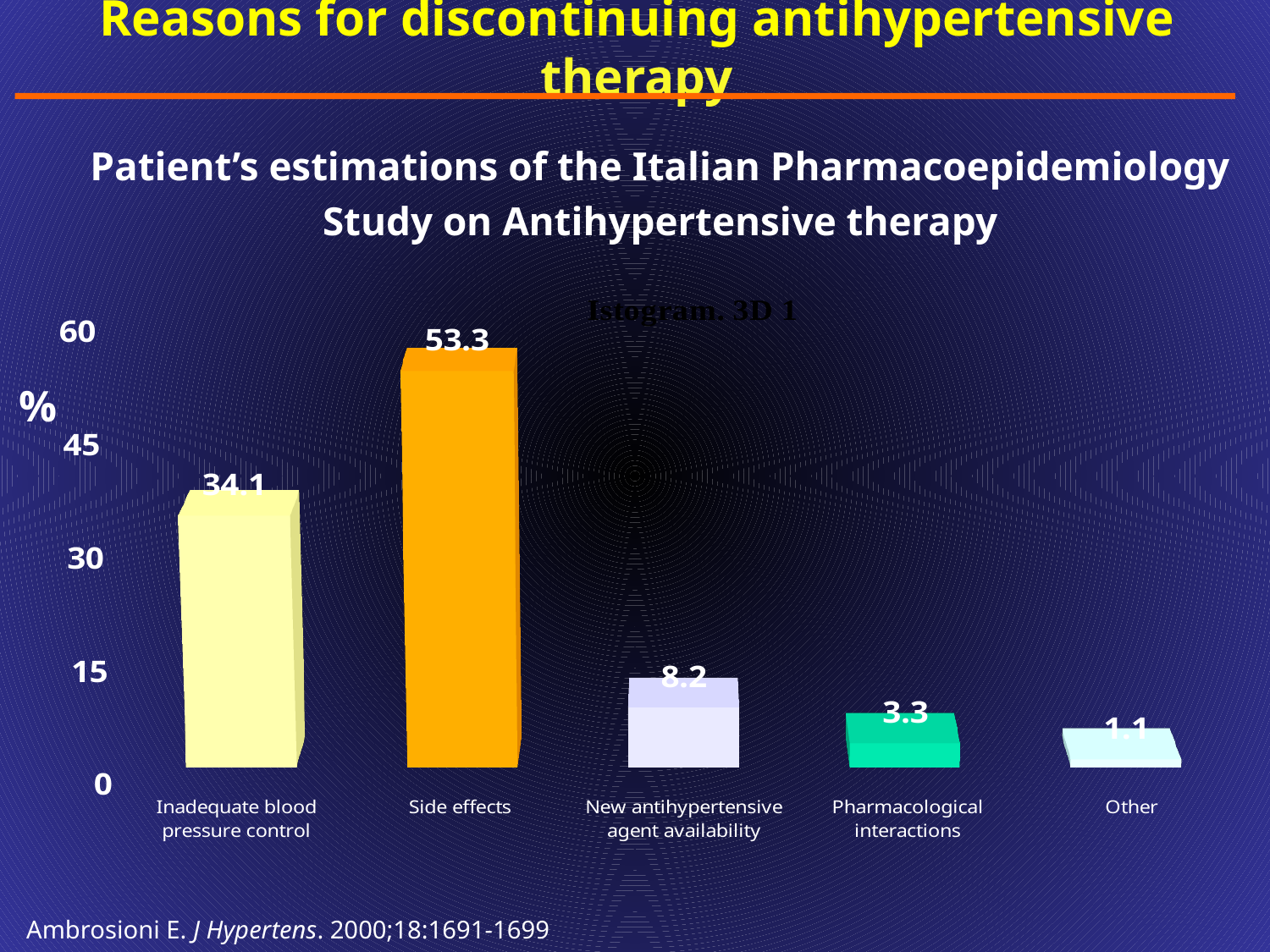
What is the value for Pharmacological interactions? 3.3 What unit is shown on the vertical axis of the chart? % What is the value for Inadequate blood pressure control? 34.1 Which is larger, the value for New antihypertensive agent availability or the value for Pharmacological interactions? New antihypertensive agent availability What is the value for Side effects? 53.3 Which category has the lowest value? Other What is the value for New antihypertensive agent availability? 8.2 How many categories are shown on the chart? 5 What is the value for Other? 1.1 What kind of chart is shown on the slide? Bar chart Which category has the highest value? Side effects What is the difference between the values for Side effects and Inadequate blood pressure control? 19.2